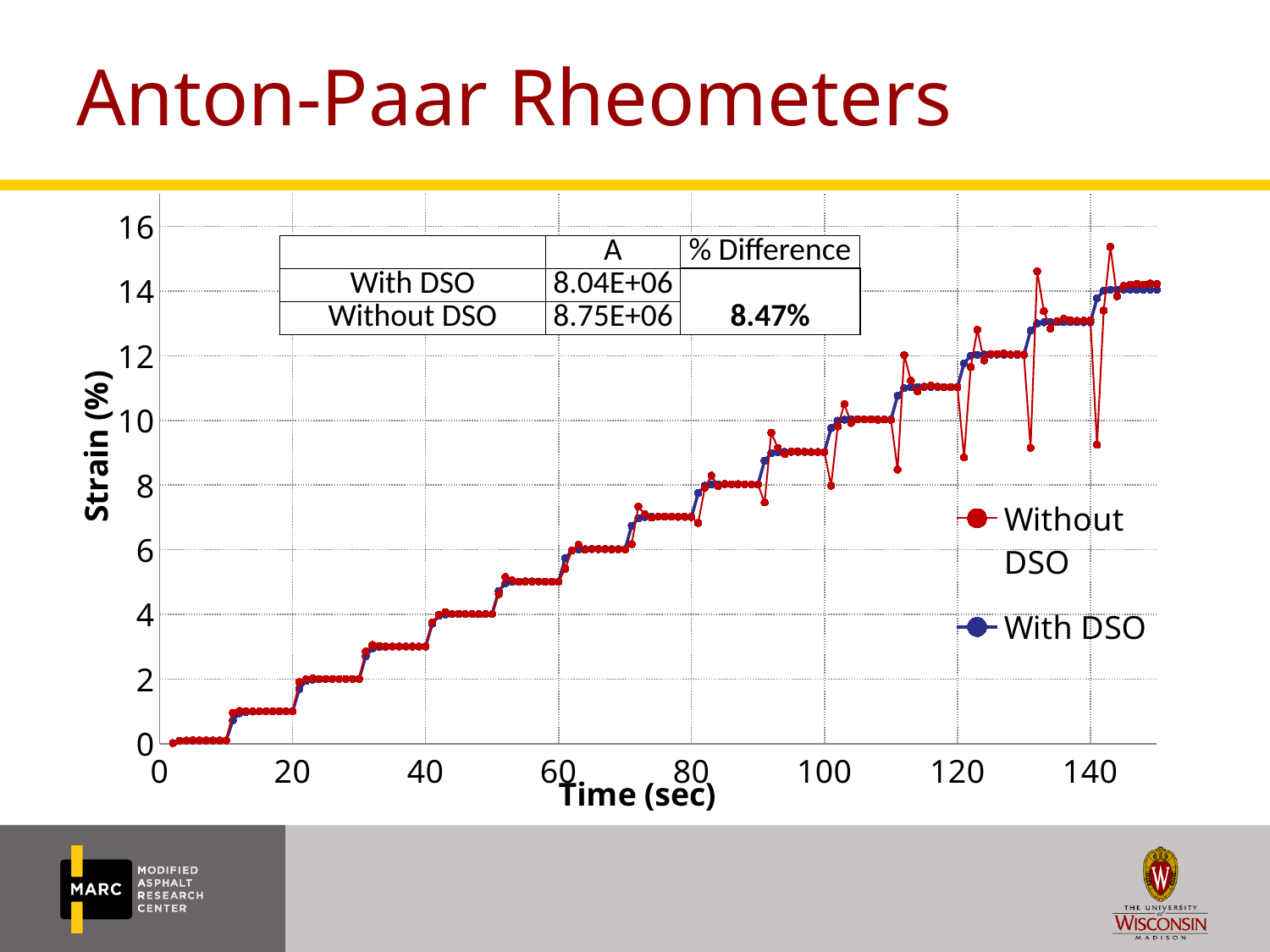
Is the strain for With DSO at time 20 sec greater or less than 4? less How many series does the chart legend list? 2 Do the strain values rise or fall as time increases along the x axis? rise Which series reaches the highest strain value on the chart? Without DSO In the table on the chart, what is the value of A for With DSO? 8.04E+06 In the table on the chart, what is the value of A for Without DSO? 8.75E+06 What kind of chart is shown on the slide? line chart Is the strain for With DSO at time 100 sec greater or less than 6? greater In the table on the chart, what is the % Difference shown? 8.47% What is the label of the y axis of the chart? Strain (%) Is the strain for Without DSO at time 140 sec greater or less than 10? greater What are the two series named in the chart legend? Without DSO and With DSO